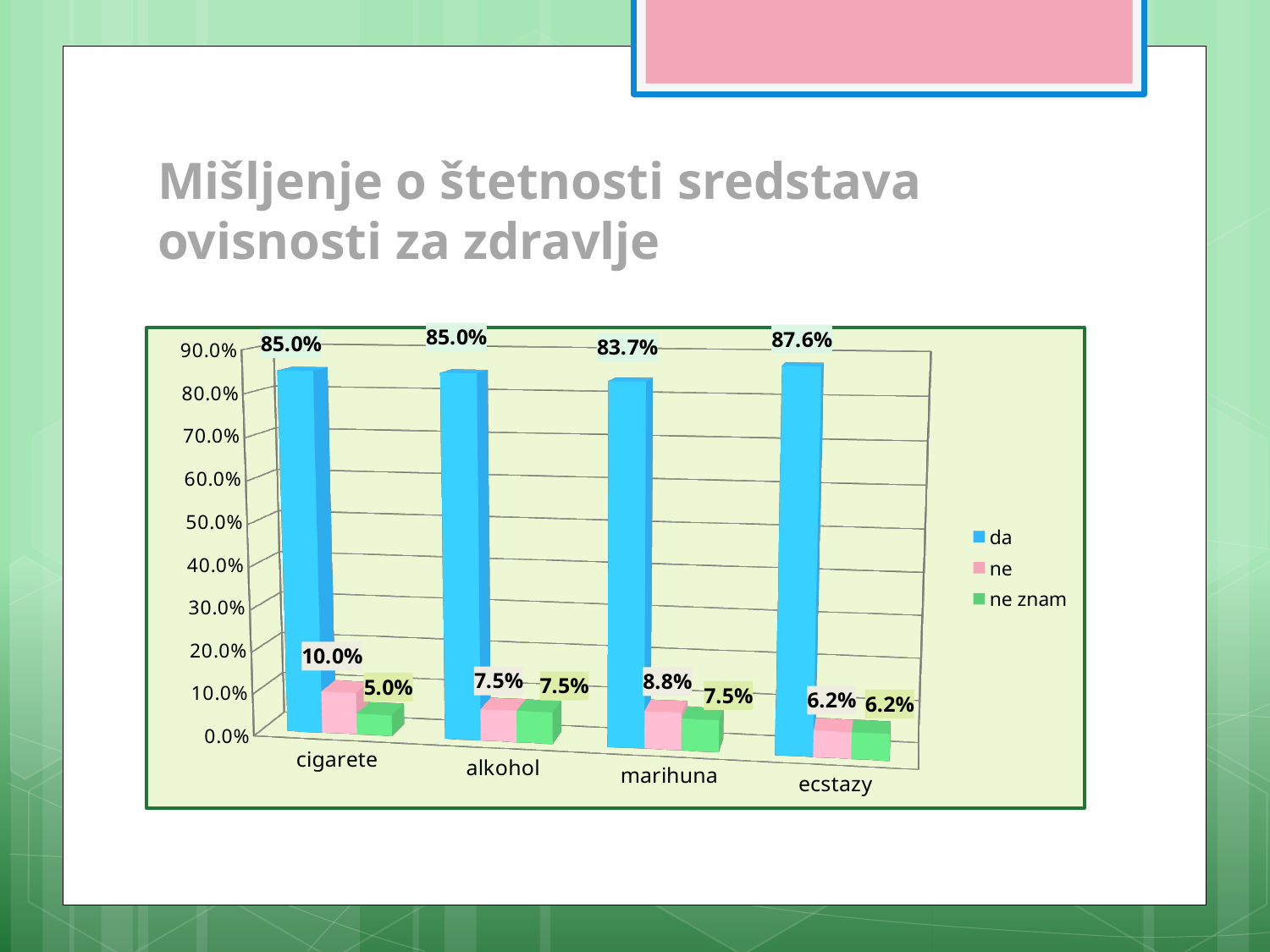
Which category has the lowest value in the "ne znam" series? cigarete What kind of chart is shown on the slide? bar chart What is the title of the slide above the chart? Mišljenje o štetnosti sredstava ovisnosti za zdravlje Which is larger: the "ne" value for cigarete or the "ne" value for alkohol? cigarete How many categories are shown on the x axis? 4 What is the value of the "da" series for cigarete? 85.0% How many series does the legend list? 3 Which category has the highest value in the "da" series? ecstazy What is the difference between the "da" values for ecstazy and marihuna? 3.9% What is the value of the "ne" series for marihuna? 8.8% Which colour represents the "ne" series in the legend? pink What is the value of the "ne znam" series for ecstazy? 6.2%